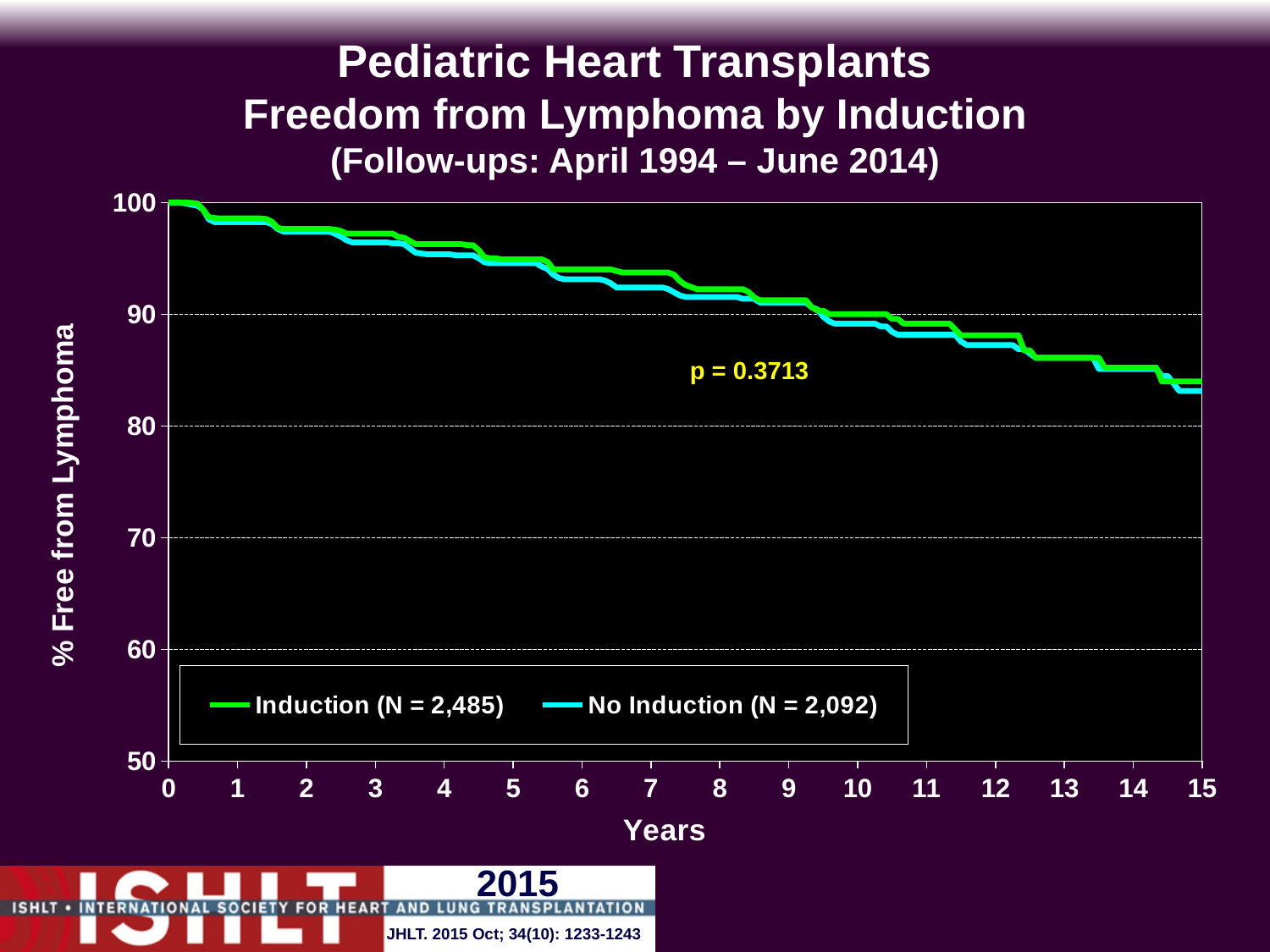
Is the value for the Induction group at year 5 greater or less than 90? greater Is the value for the No Induction group at year 15 greater or less than 80? greater Is the value for the No Induction group at year 8 greater or less than 90? greater What kind of chart is shown on the slide? Line chart What is the % Free from Lymphoma for the Induction group at year 0? 100 What is the N for the No Induction group shown in the legend? 2,092 What is the p value printed on the chart? p = 0.3713 Do the curves rise or fall as the years increase along the x axis? Fall How many series does the legend list? 2